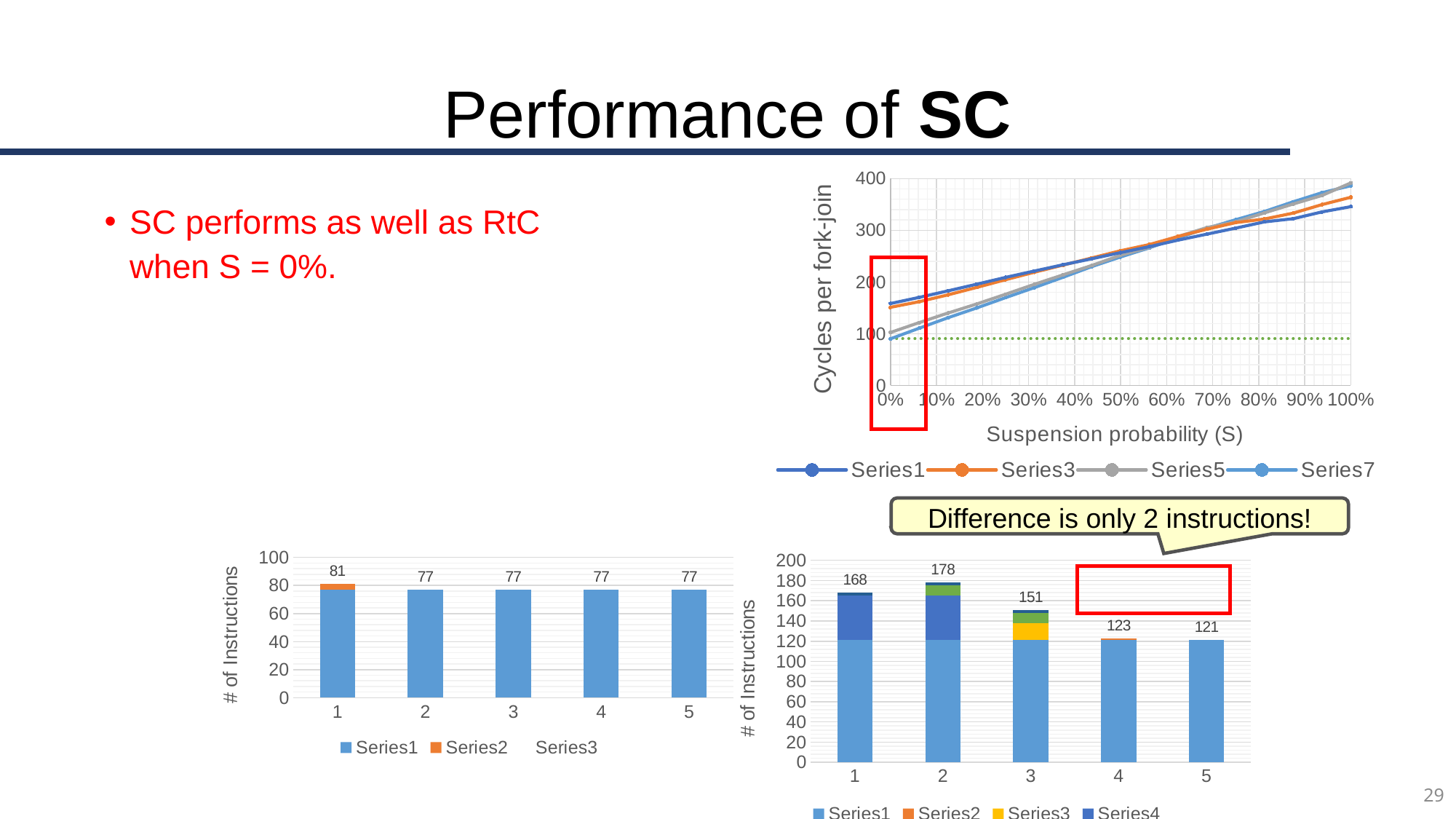
In the bottom-right bar chart, how many series does the legend list? 4 What kind of chart is the top-right chart titled with the y axis 'Cycles per fork-join'? line chart In the bottom-right bar chart, which category has the highest total? 2 In the bottom-right bar chart, what is the difference between the totals for category 4 and category 5? 2 In the bottom-left bar chart, how many categories are shown on the x axis? 5 In the top-right line chart, is the value of Series7 at 0% greater or less than 100? less In the bottom-left bar chart, what is the total labelled for category 1? 81 In the bottom-right bar chart, which category has the lowest total? 5 In the bottom-left bar chart, what is the difference between the totals for category 1 and category 2? 4 In the top-right line chart, do the values of Series1 rise or fall as the suspension probability increases? rise In the bottom-right bar chart, what is the total labelled for category 2? 178 In the bottom-left bar chart, which category has the highest total? 1